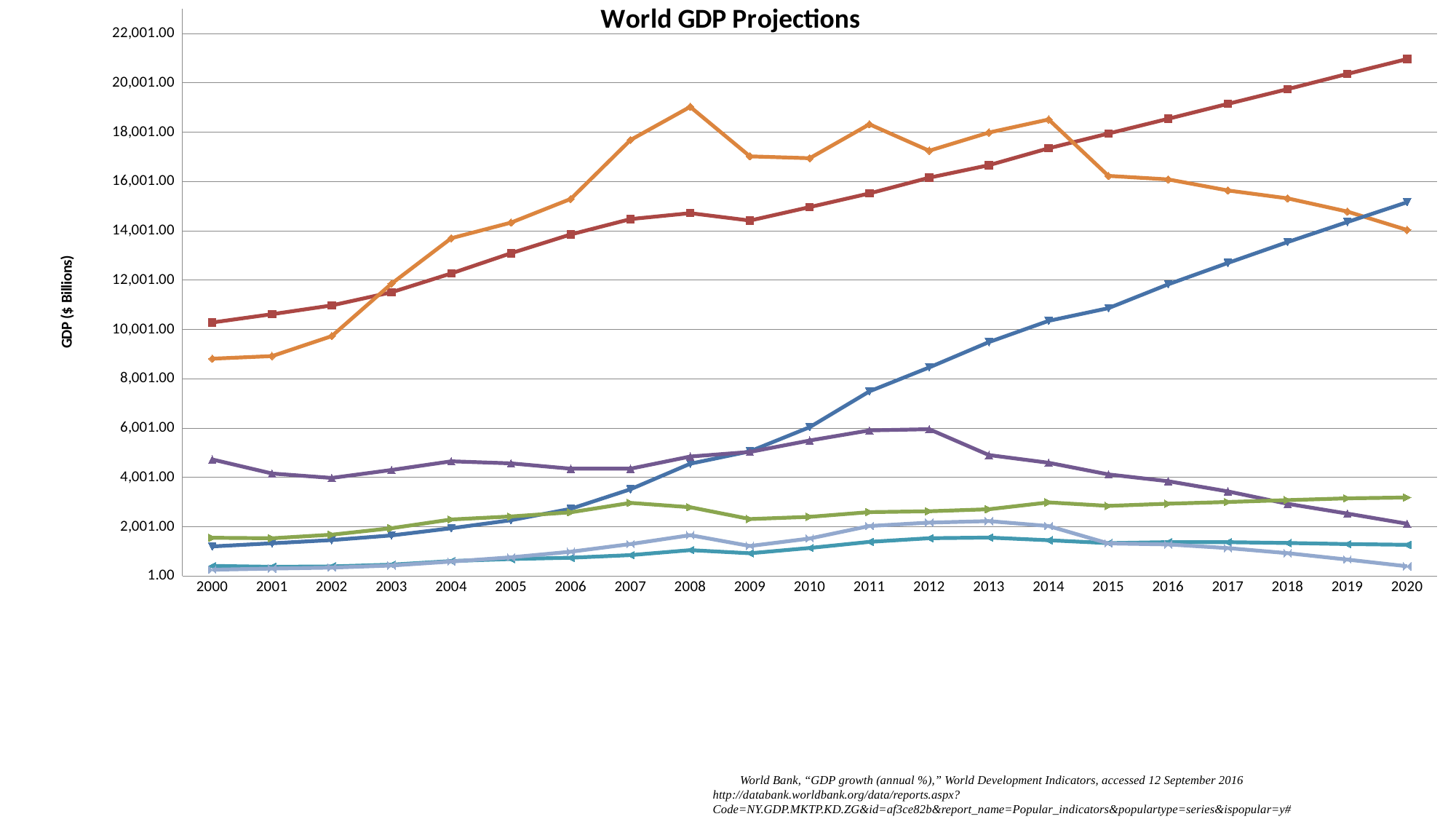
In 2020, which is higher: the blue line or the orange line? The blue line Does the orange line rise or fall from 2014 to 2020? Falls How many years are plotted along the x axis of the chart? 21 Does the red line rise or fall from 2000 to 2020? Rises Is the value of the red line in 2020 greater or less than 20,001.00? greater Which line has the highest value in 2020? The red line What is the label on the vertical axis of the chart? GDP ($ Billions) How many lines (series) are plotted on the chart? 7 In which year does the orange line reach its peak? 2008 Which line has the highest value in 2008? The orange line What is the title of the chart? World GDP Projections What type of chart is shown on the slide? Line chart